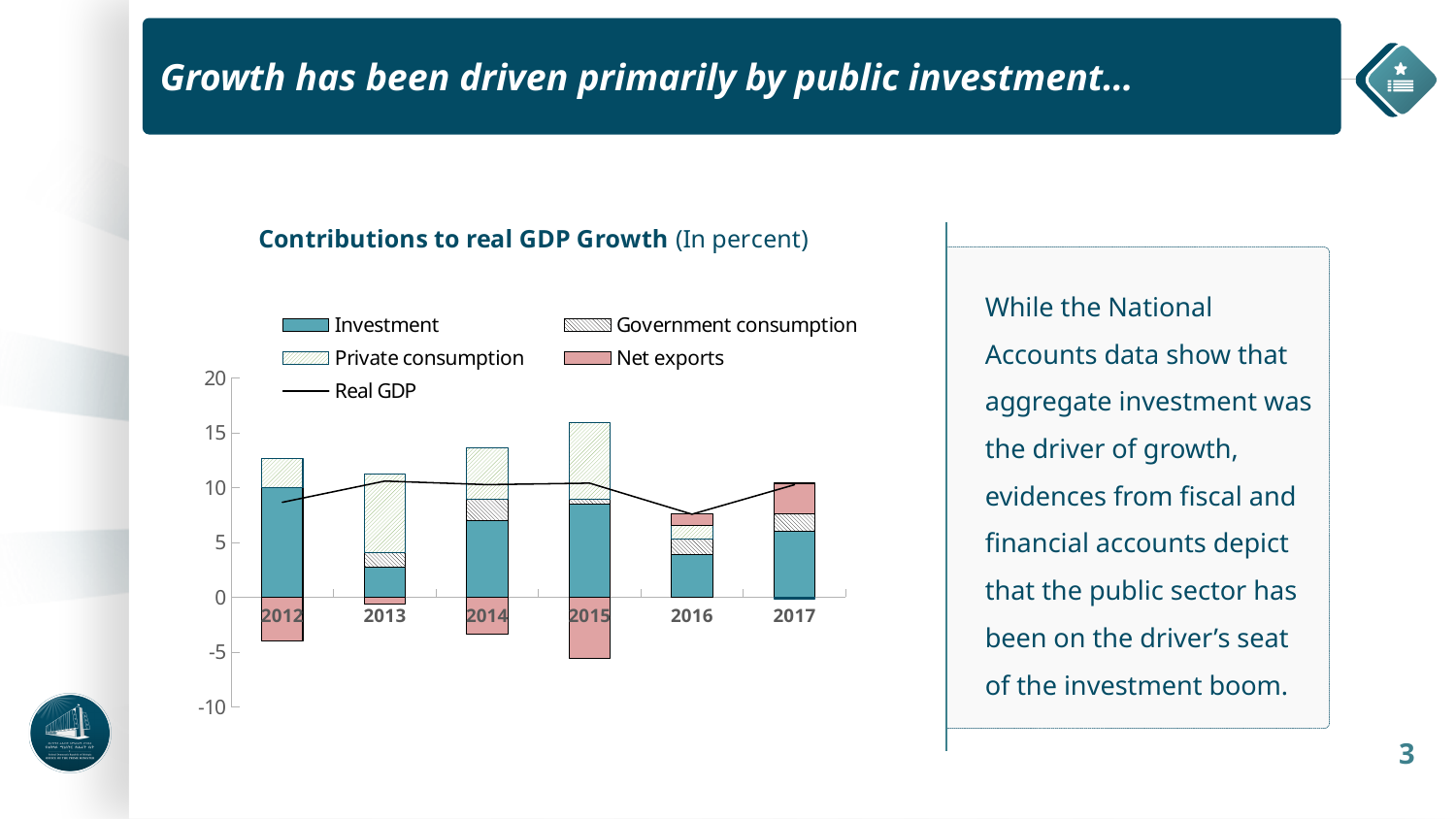
How many years are shown on the x axis of the chart? 6 What kind of chart is shown on the slide? Stacked bar chart with a line Which year has the larger Investment contribution, 2013 or 2014? 2014 Is the Investment contribution in 2014 greater or less than 5? greater Is the Investment contribution in 2016 greater or less than 5? less In which year is the Net exports contribution the most negative? 2015 In which year is the Investment contribution the highest? 2012 Is the Real GDP value in 2016 greater or less than 10? less What is the title of the chart? Contributions to real GDP Growth How many series does the chart's legend list? 5 In what unit are the values in the chart expressed? Percent